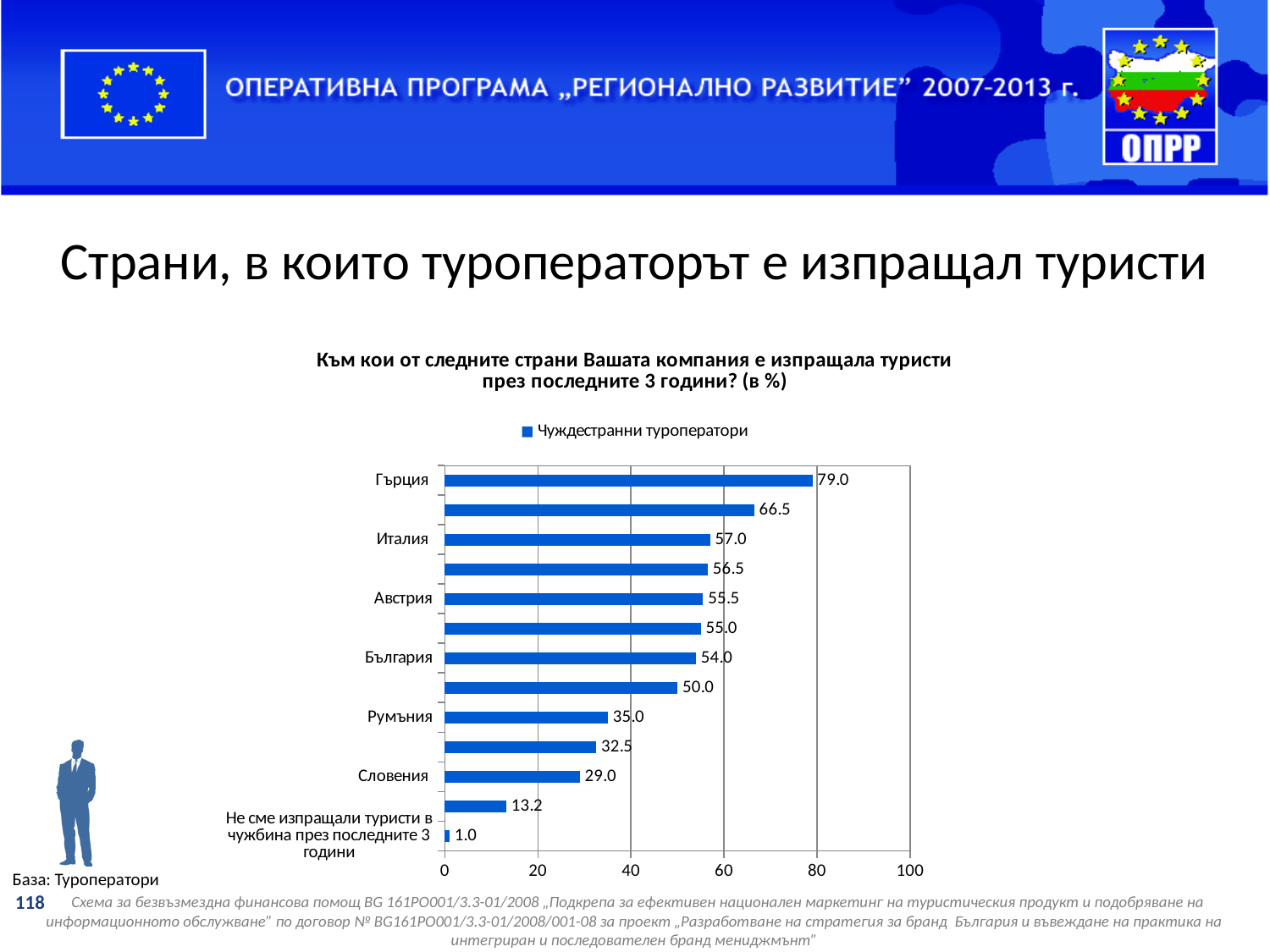
What is the value for Австрия? 55.5 Which is larger, the value for Италия or the value for Словения? Италия What is the value for Гърция? 79.0 How many series does the legend list? 1 What is the value for Словения? 29.0 What is the value for България? 54.0 What is the value for Италия? 57.0 What is the value for Румъния? 35.0 Which category has the lowest value? Не сме изпращали туристи в чужбина през последните 3 години Which category has the highest value? Гърция What is the difference between the values for Гърция and Румъния? 44.0 What type of chart is shown on the slide? bar chart